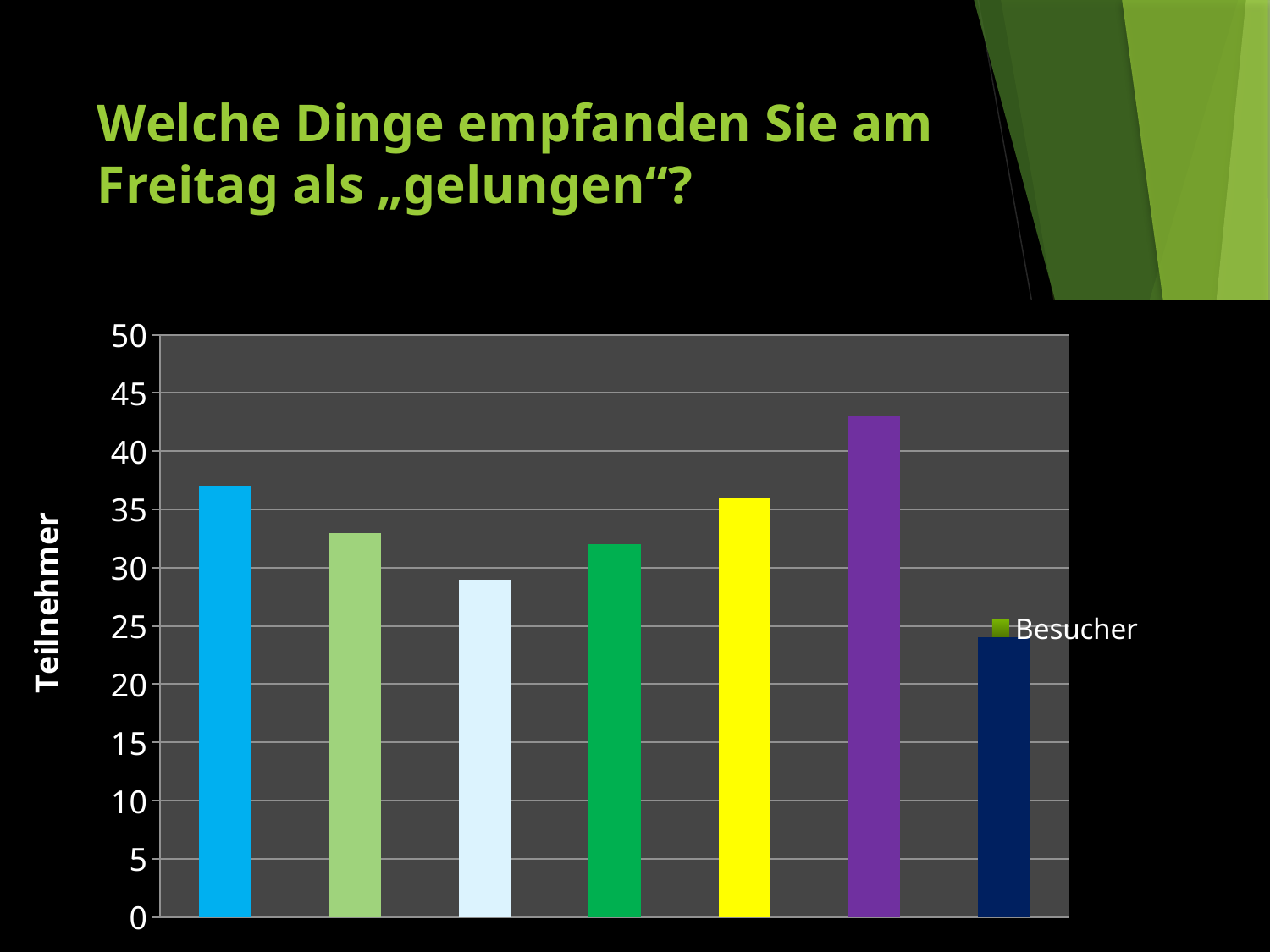
Which is larger, the value of the purple bar or the value of the blue bar on the far left? the purple bar What kind of chart is shown on the slide? bar chart What is the name of the series shown in the legend? Besucher Is the value of the light green bar (second from the left) greater or less than 30? greater Is the value of the purple bar greater or less than 40? greater How many series does the legend list? 1 Is the value of the very light blue bar (third from the left) greater or less than 25? greater What is the title of the vertical axis? Teilnehmer Which bar is the shortest in the chart? the dark navy bar (rightmost) Which bar is the tallest in the chart? the purple bar (sixth from the left) How many bars are plotted in the chart? 7